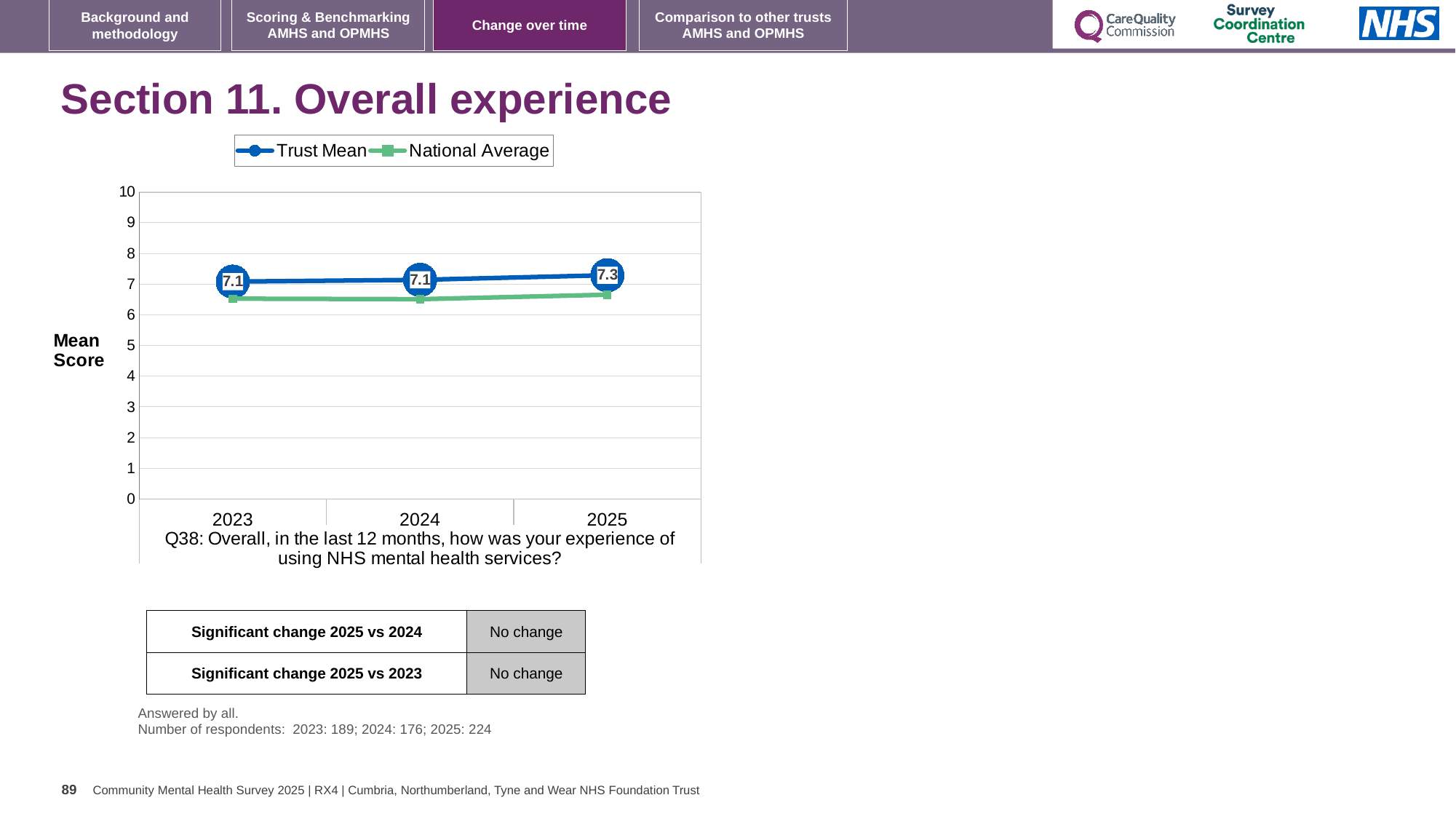
Which is larger in 2025, the Trust Mean or the National Average? Trust Mean What is the difference between the Trust Mean in 2025 and in 2024? 0.2 How many years are shown on the x axis? 3 What is the Trust Mean score for 2024? 7.1 Is the National Average for 2025 greater or less than 6? greater Is the National Average for 2023 greater or less than 7? less What is the Trust Mean score for 2025? 7.3 What is the Trust Mean score for 2023? 7.1 In which year is the Trust Mean highest? 2025 Does the Trust Mean rise or fall from 2024 to 2025? rise How many series does the legend list? 2 What kind of chart is shown? line chart